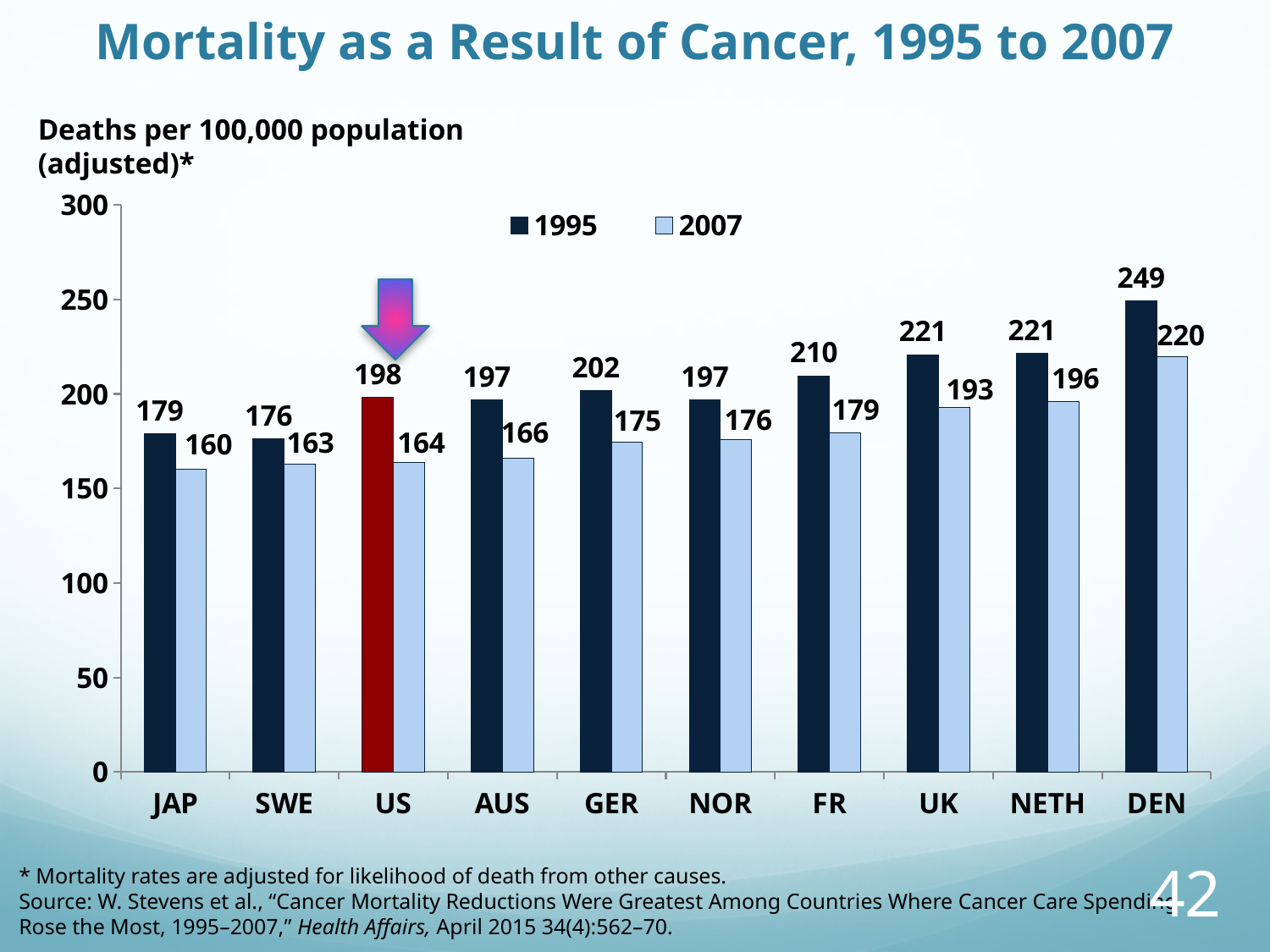
Which country had the highest cancer mortality rate in 1995? DEN What is the difference between the 2007 values for the UK and Japan (JAP)? 33 How many series does the legend list? 2 Which country had the lowest cancer mortality rate in 2007? JAP Which was higher in 2007, the value for France (FR) or Germany (GER)? FR What was the cancer mortality rate for the US in 1995? 198 Did the cancer mortality rate rise or fall from 1995 to 2007 for every country shown? Fall What kind of chart is shown on the slide? Bar chart Which country's 1995 bar is highlighted in red? US What was the cancer mortality rate for Denmark (DEN) in 2007? 220 By how much did the US cancer mortality rate fall from 1995 to 2007? 34 How many countries are shown on the chart? 10